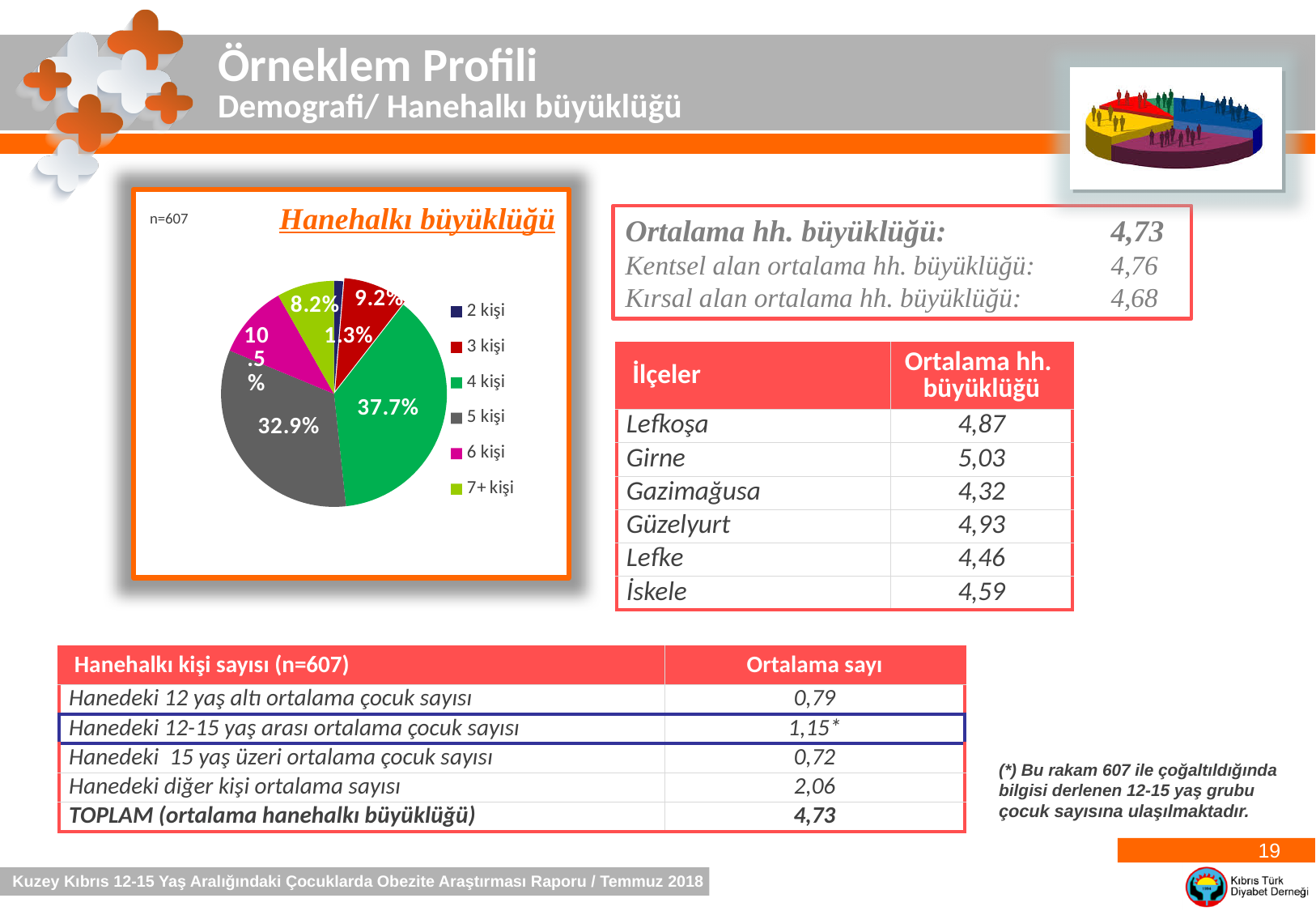
Which slice is larger, '6 kişi' or '7+ kişi'? 6 kişi What share of the pie does the '7+ kişi' slice represent? 8.2% What share of the pie does the '6 kişi' slice represent? 10.5% Which household size category has the largest slice of the pie? 4 kişi What type of chart is shown on the slide? pie chart What is the difference in percentage points between the '4 kişi' and '5 kişi' slices? 4.8 What share of the pie does the '3 kişi' slice represent? 9.2% What share of the pie does the '4 kişi' slice represent? 37.7% How many categories does the pie chart legend list? 6 Which household size category has the smallest slice of the pie? 2 kişi What is the title of the chart? Hanehalkı büyüklüğü What share of the pie does the '5 kişi' slice represent? 32.9%